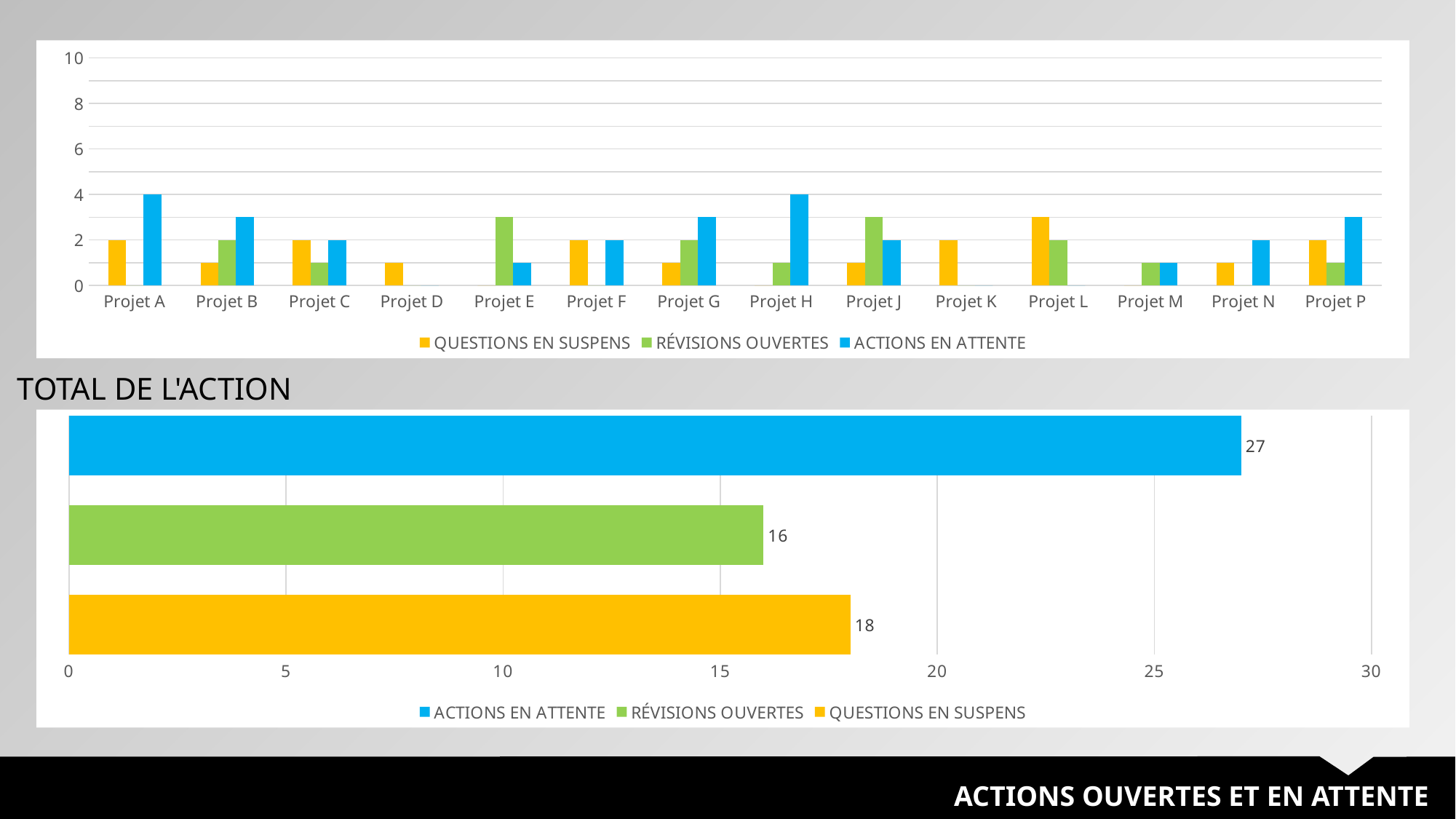
In the bottom chart titled TOTAL DE L'ACTION, what is the value for ACTIONS EN ATTENTE? 27 In the bottom chart titled TOTAL DE L'ACTION, which series has the highest value? ACTIONS EN ATTENTE In the bottom chart titled TOTAL DE L'ACTION, which series has the lowest value? RÉVISIONS OUVERTES In the top chart, what is the value of ACTIONS EN ATTENTE for Projet A? 4 In the bottom chart titled TOTAL DE L'ACTION, what is the value for QUESTIONS EN SUSPENS? 18 In the top chart, is the value of RÉVISIONS OUVERTES for Projet E greater or less than 2? greater In the bottom chart titled TOTAL DE L'ACTION, what is the value for RÉVISIONS OUVERTES? 16 In the bottom chart titled TOTAL DE L'ACTION, what is the difference between ACTIONS EN ATTENTE and QUESTIONS EN SUSPENS? 9 In the top chart, how many series does the legend list? 3 In the bottom chart titled TOTAL DE L'ACTION, what type of chart is shown? Bar chart In the top chart, how many projects are shown on the x axis? 14